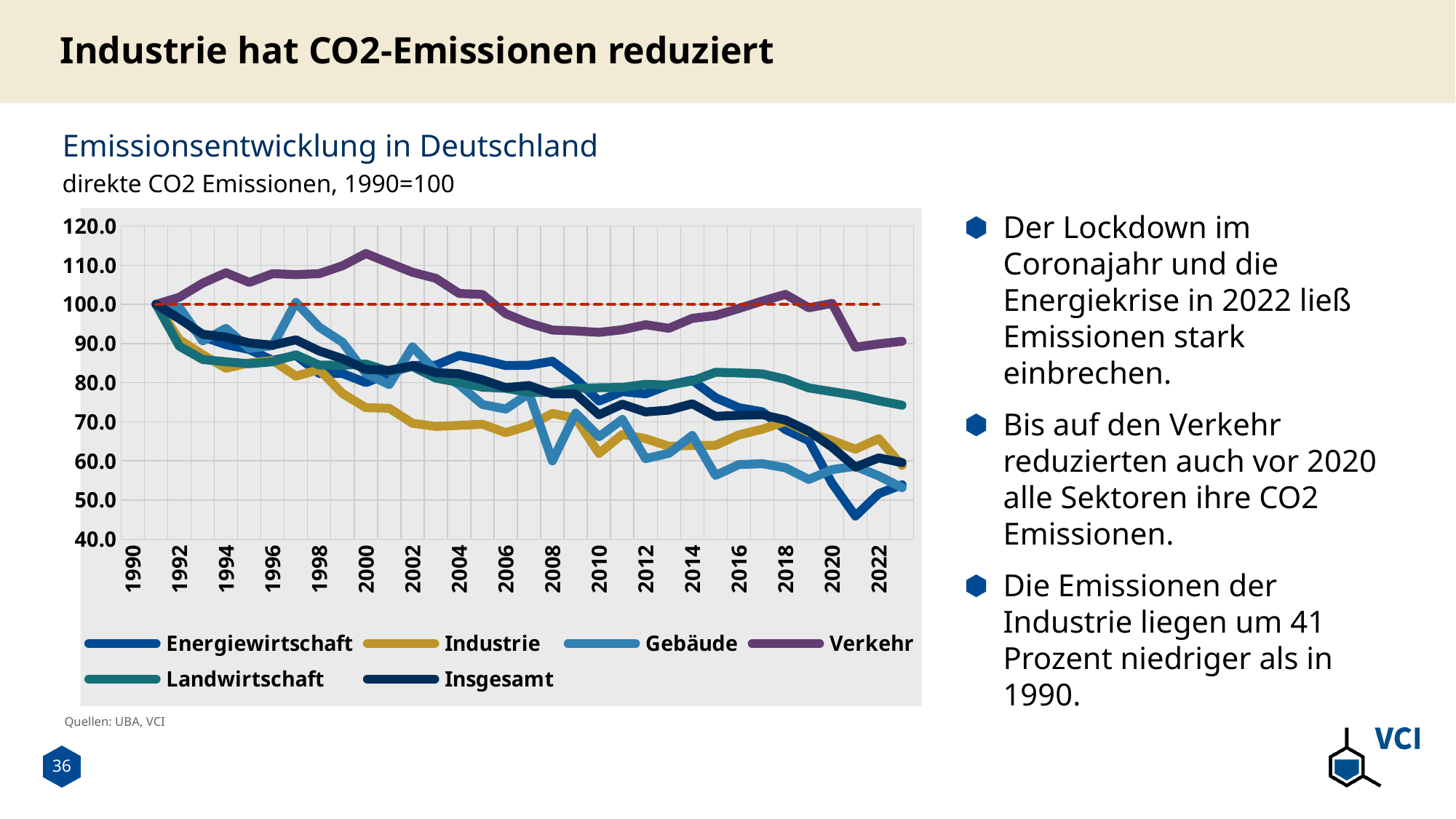
What kind of chart is shown on the slide? line chart Which series has the lowest value in 2021? Energiewirtschaft Which series has the highest value in 2000? Verkehr Does the Industrie series rise or fall from 1990 to 2022? fall In 2022, which is higher: Landwirtschaft or Gebäude? Landwirtschaft What is the value of the Insgesamt series in 1990? 100.0 Is the value for Energiewirtschaft in 2021 greater or less than 50? less How many series does the legend of the chart list? 6 At what value is the dashed red reference line drawn? 100.0 Is the value for Landwirtschaft in 2022 greater or less than 80? less Is the value for Verkehr in 2000 greater or less than 110? greater What is the title of the chart? Emissionsentwicklung in Deutschland